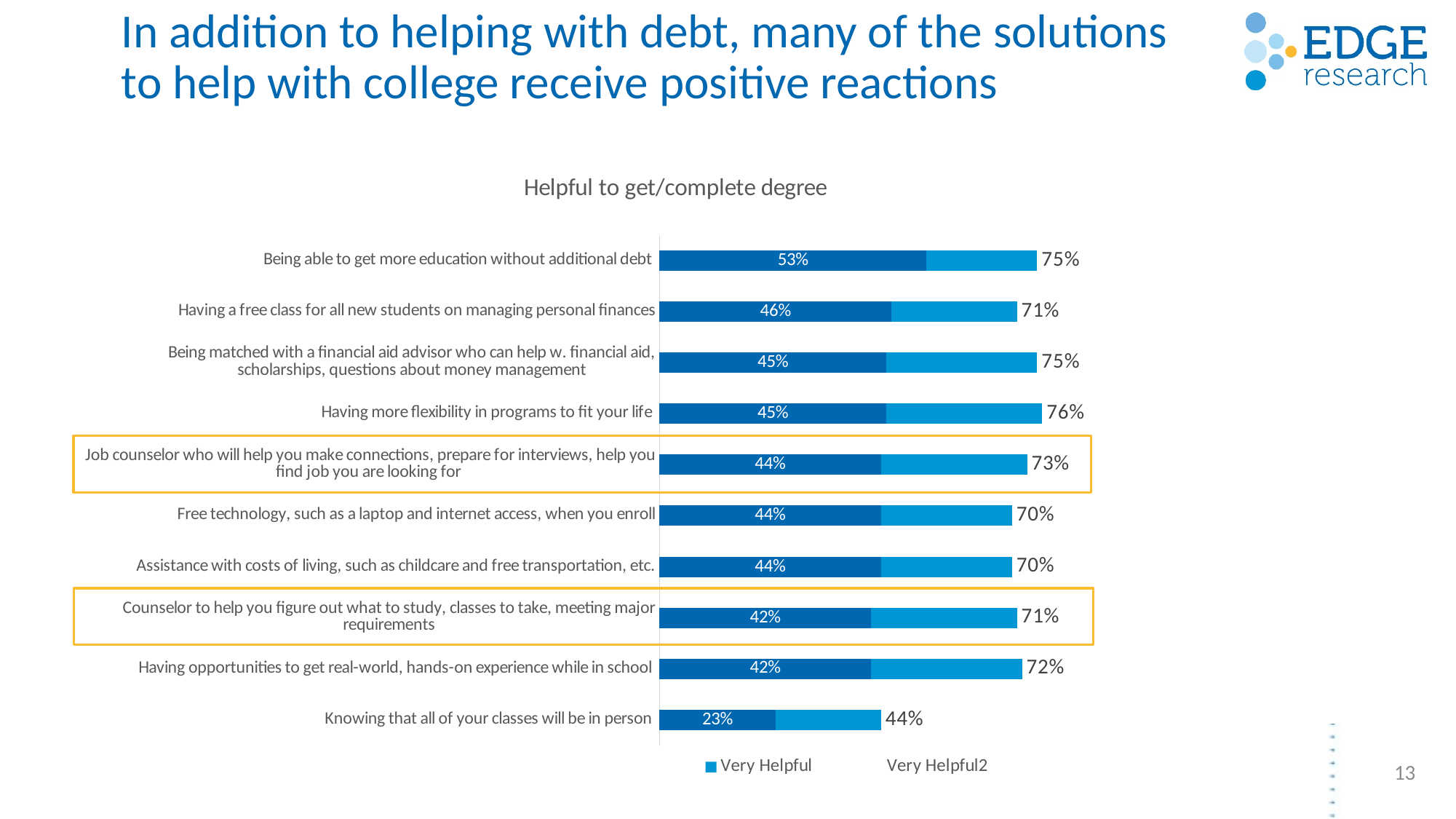
What value is shown at the end of the bar for 'Having opportunities to get real-world, hands-on experience while in school'? 72% What value is shown at the end of the bar for 'Having more flexibility in programs to fit your life'? 76% Which item has the highest value shown at the end of its bar? Having more flexibility in programs to fit your life What type of chart is shown on the slide? Stacked bar chart How many items are listed in the chart? 10 How many series does the legend list? 2